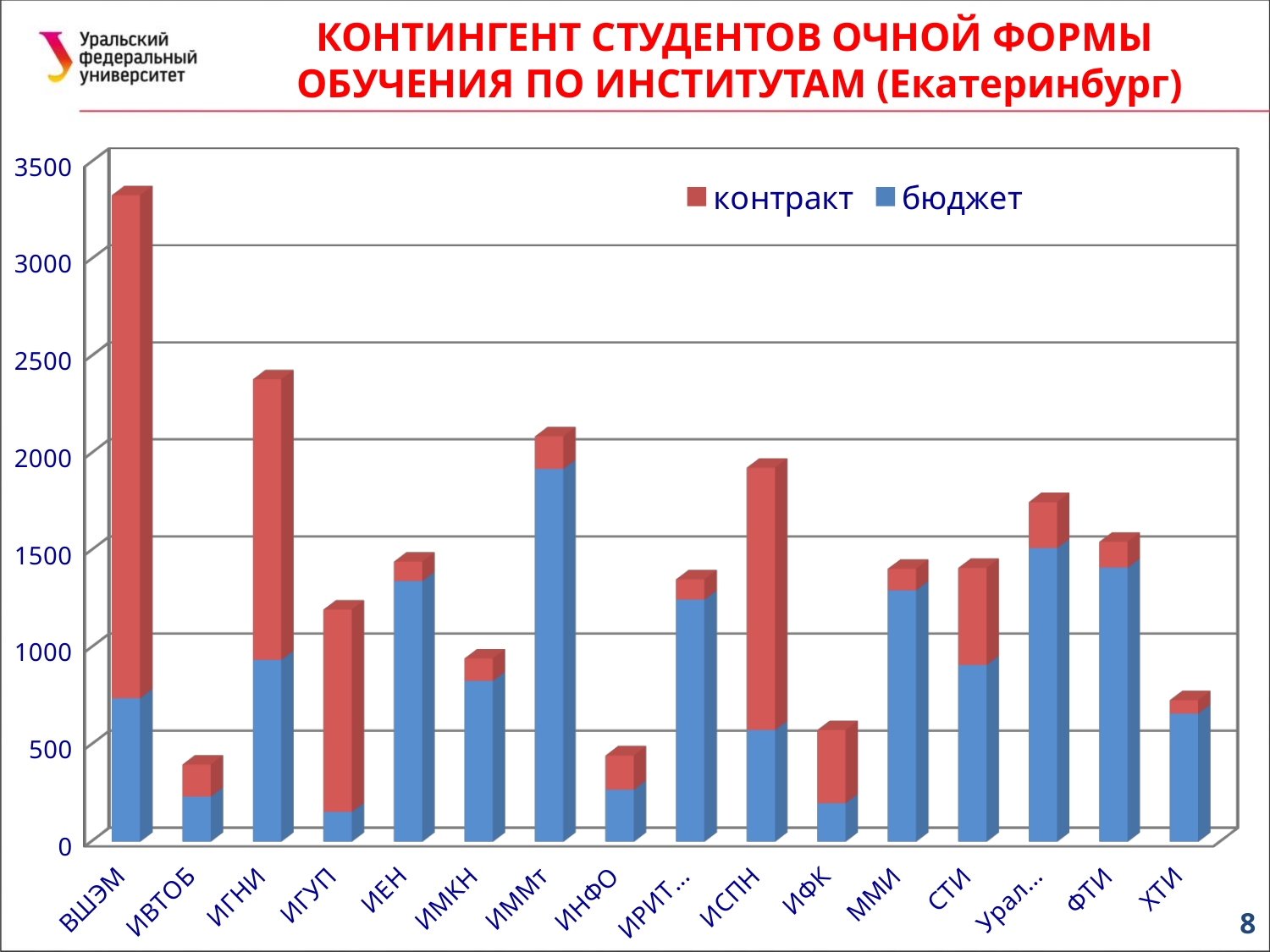
Which institute has the largest бюджет (blue) segment? ИММт Is the total value for ИВТОБ greater or less than 500? less Is the total value for ХТИ greater or less than 1000? less Which institute has the lowest total bar? ИВТОБ How many series does the legend list? 2 Which has the larger total bar, ВШЭМ or ИГНИ? ВШЭМ How many institutes (categories) are shown on the x axis? 16 Which colour represents the контракт series in the legend? red Which institute has the highest total bar? ВШЭМ Is the бюджет value for ИММт greater or less than 1500? greater What kind of chart is shown on the slide? stacked bar chart